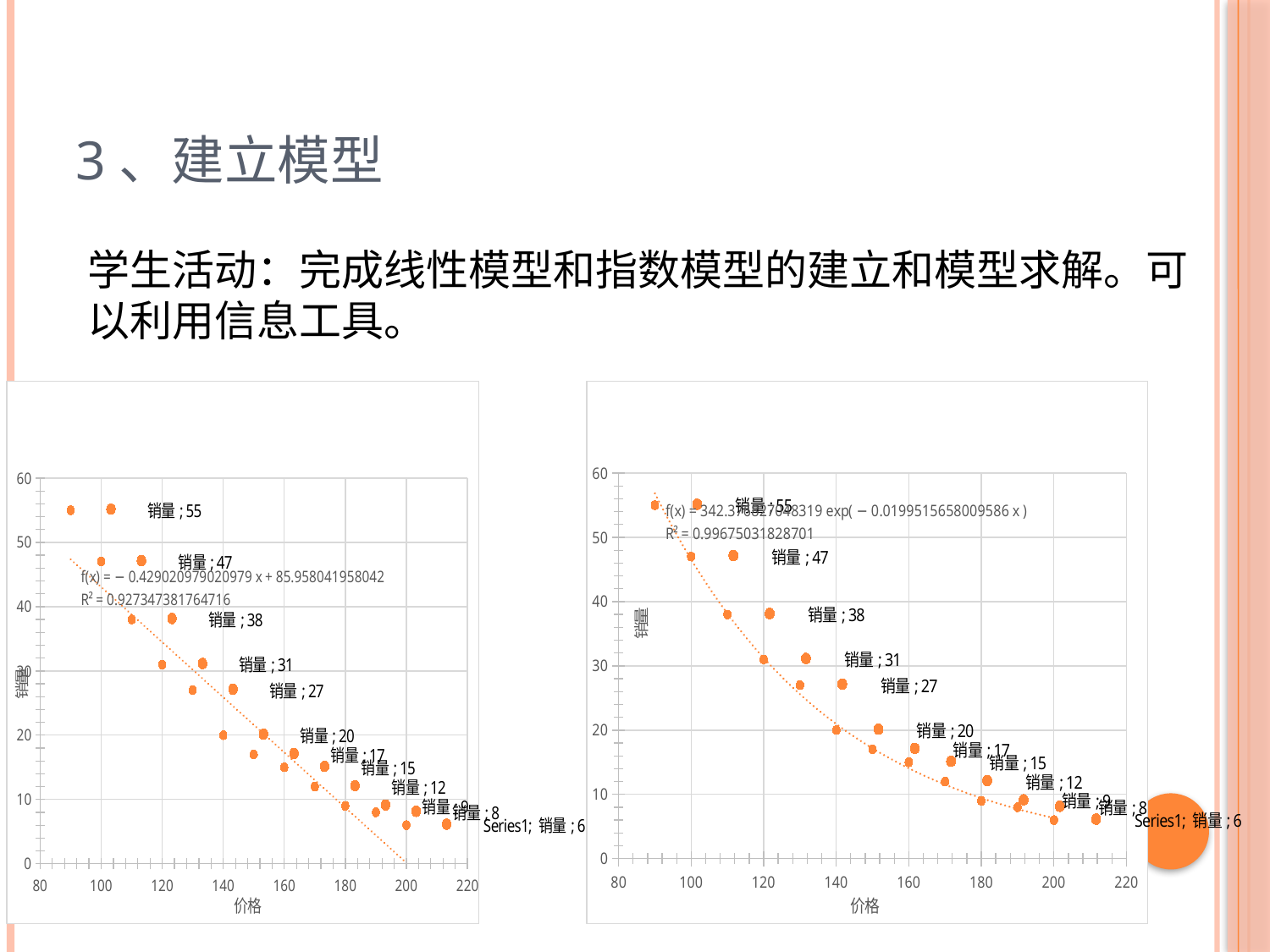
What R² value is shown on the right chart? 0.99675031828701 In the left chart, do the 销量 values rise or fall as 价格 increases? fall In the left chart, what is the lowest 销量 value labelled? 6 In the left chart, what is the 销量 value for the point at 价格 90? 55 In the right chart, what is the highest 销量 value labelled? 55 In the left chart, is the 销量 value at 价格 110 greater or less than 40? less In the right chart, what is the 销量 value for the point at 价格 200? 6 In the left chart, how many data points are plotted? 12 In the right chart, which is larger: the 销量 at 价格 120 or the 销量 at 价格 140? 价格 120 In the right chart, what is the difference between the highest labelled 销量 (55) and the lowest labelled 销量 (6)? 49 What is the x-axis title of the left chart? 价格 What kind of chart is shown on the left side of the slide? scatter chart